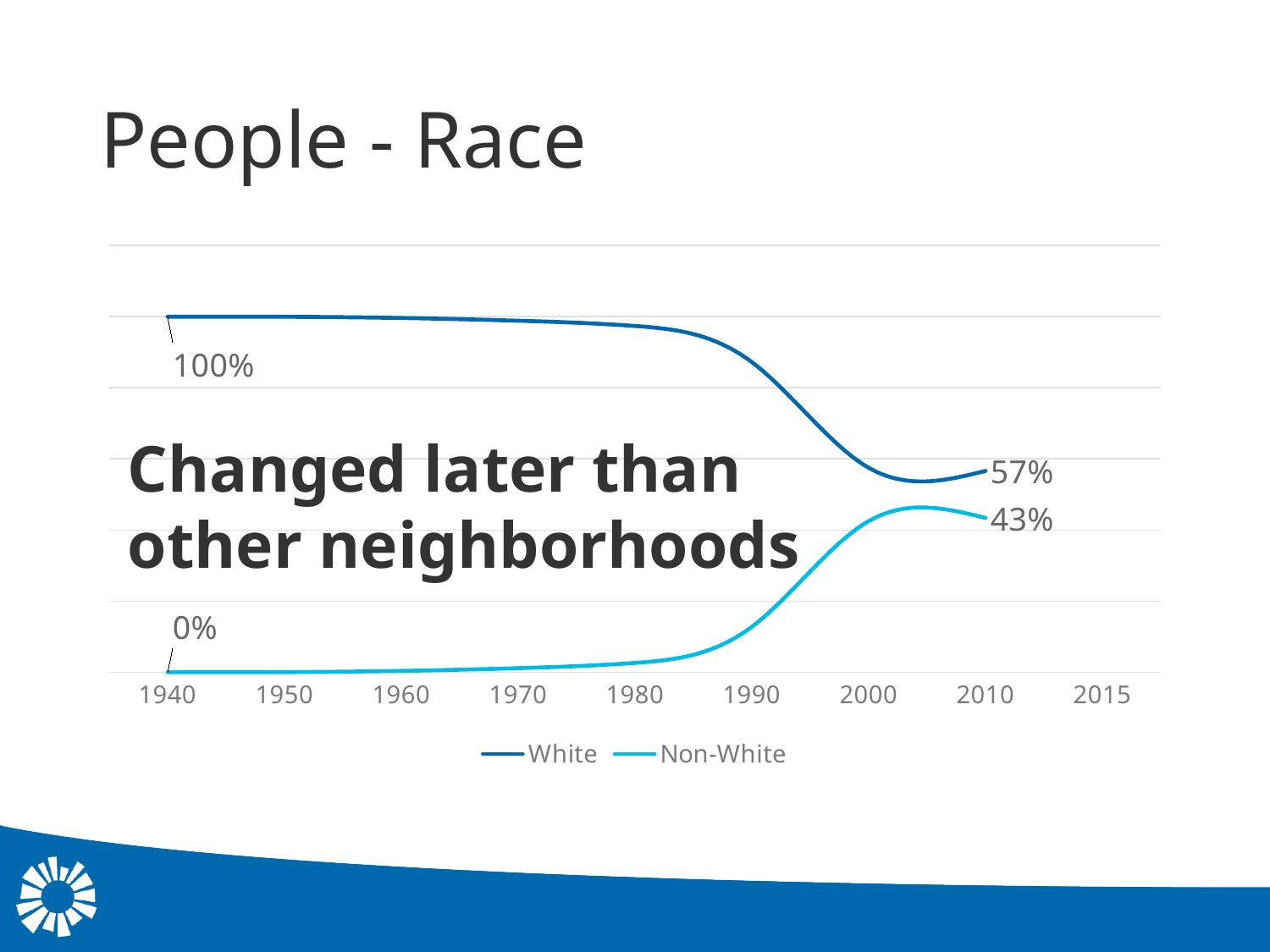
What kind of chart is shown on the slide? line chart Does the White line rise or fall from 1940 to 2010? fall What is the value for Non-White in 2010? 43% What is the value for White in 2010? 57% By how much did the White value fall from 1940 to 2010? 43% What is the value for White in 1940? 100% Does the Non-White line rise or fall from 1940 to 2010? rise What is the value for Non-White in 1940? 0% What is the difference between the White and Non-White values in 2010? 14% In 2010, which series has the larger value, White or Non-White? White How many series does the legend list? 2 What are the two entries in the chart legend? White and Non-White